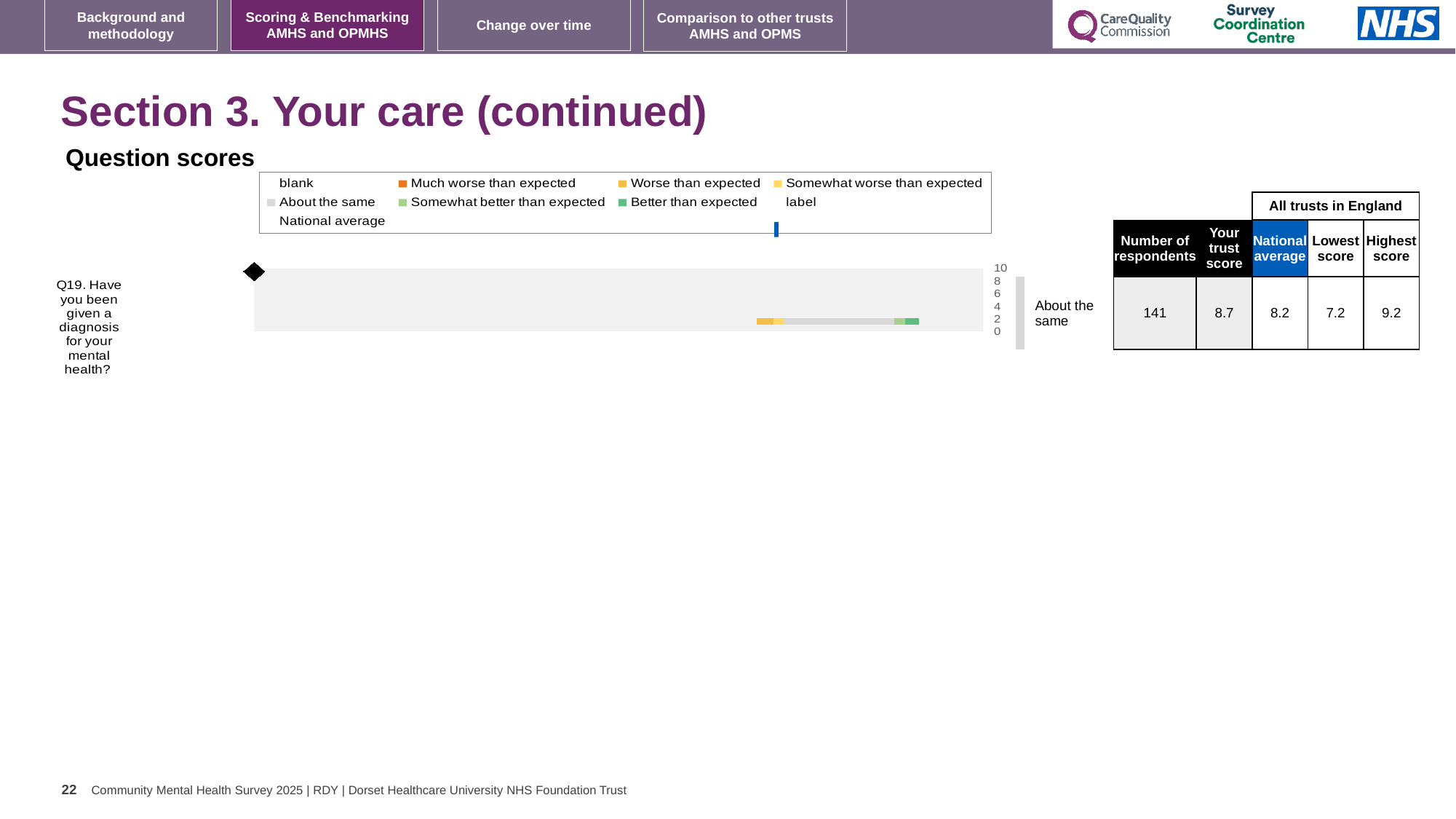
What is the lowest score among all trusts in England for Q19? 7.2 What is the national average score for Q19? 8.2 What is the highest score among all trusts in England for Q19? 9.2 How many questions are plotted in the Question scores chart? 1 Which legend entry is shown in orange in the Question scores chart? Much worse than expected How many respondents answered Q19? 141 What is the difference between the trust's score and the national average for Q19? 0.5 What kind of chart is used to show the Q19 question score? bar chart Which is larger for Q19: the trust's score or the national average? the trust's score What is the difference between the highest and lowest scores for Q19 across all trusts in England? 2.0 What is the trust's score for Q19 (Have you been given a diagnosis for your mental health?)? 8.7 What benchmarking category is shown next to the Q19 bar? About the same